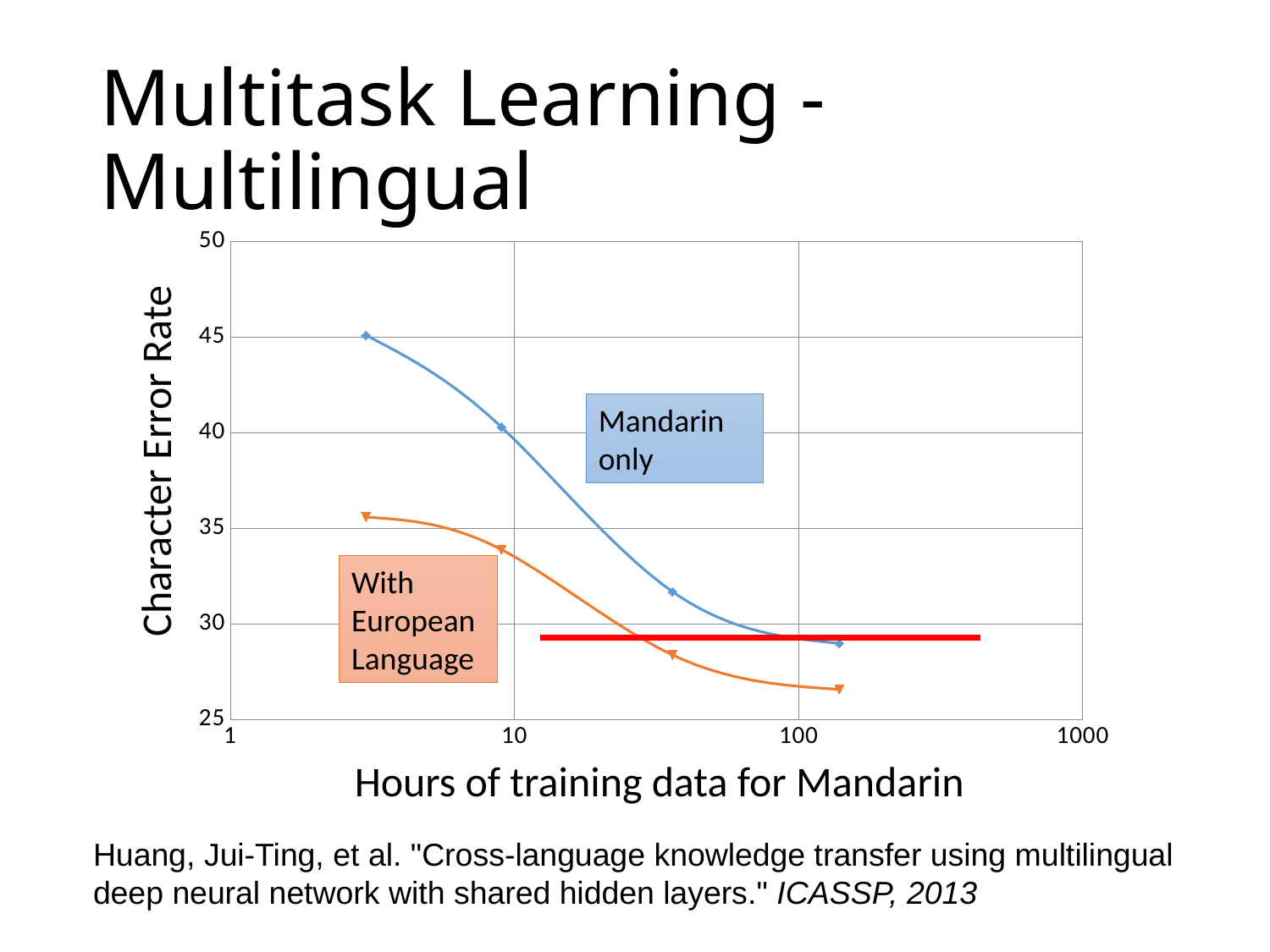
Is the Character Error Rate of the first Mandarin only point greater or less than 40? greater How many data series are plotted on the chart? 2 How many data points does the Mandarin only series have? 4 Which series has the lower Character Error Rate at the largest amount of training data? With European Language What kind of chart is shown on the slide? line chart What is the label of the y axis? Character Error Rate How many data points does the With European Language series have? 4 What is the label of the x axis? Hours of training data for Mandarin Is the Character Error Rate of the last With European Language point greater or less than 30? less Does the Character Error Rate for the Mandarin only series rise or fall as the hours of training data increase? fall Which series has the higher Character Error Rate at the smallest amount of training data? Mandarin only Does the Character Error Rate for the With European Language series rise or fall as the hours of training data increase? fall